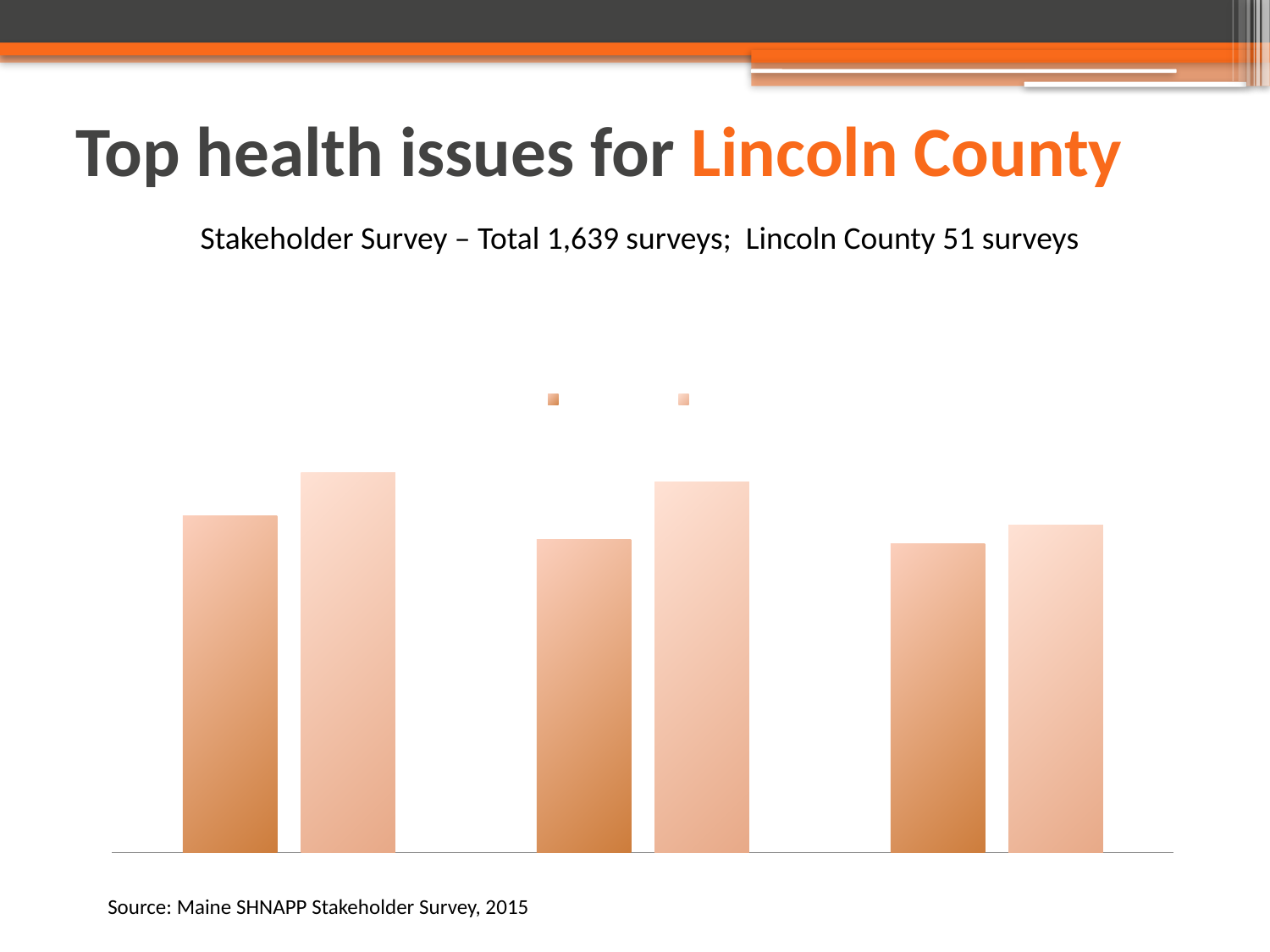
In the rightmost group of bars, is the darker bar taller or shorter than the lighter bar? shorter Are the bars on the chart vertical or horizontal? vertical How many bars are plotted in total on the chart? 6 How many groups of bars does the chart show? 3 In the leftmost group of bars, is the lighter bar taller or shorter than the darker bar? taller How many bars are in each group on the chart? 2 How many series does the chart's legend list? 2 What colour family are the bars on the chart? orange What kind of chart is shown on the slide? bar chart